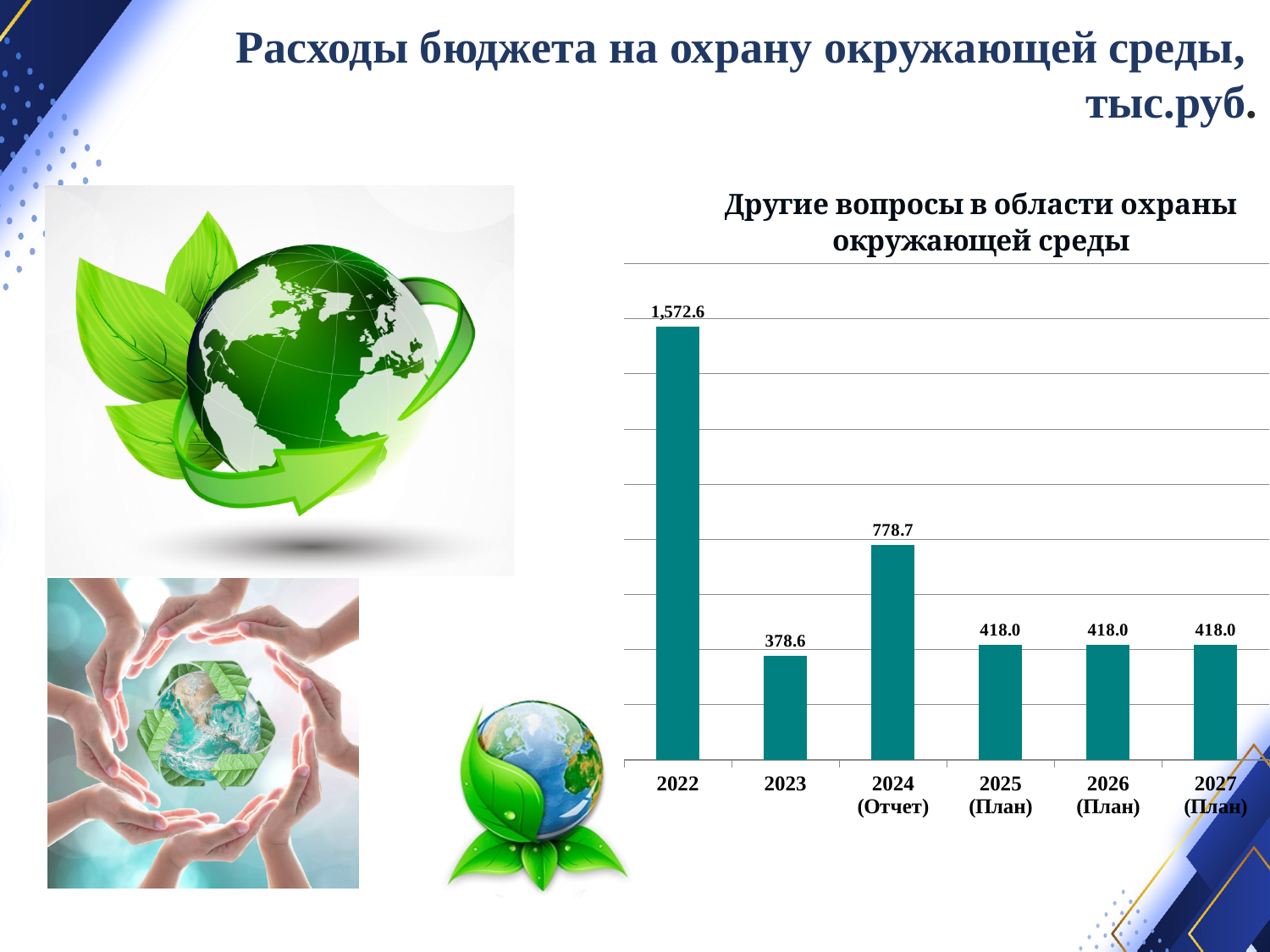
What is the value for 2022? 1,572.6 Which is larger, the value for 2023 or the value for 2025 (План)? 2025 (План) What kind of chart is shown on the slide? bar chart What is the title of the chart? Другие вопросы в области охраны окружающей среды What is the value for 2026 (План)? 418.0 How many years are shown on the x axis? 6 What is the value for 2024 (Отчет)? 778.7 What is the value for 2023? 378.6 Which year has the highest value? 2022 What is the difference between the values for 2022 and 2023? 1,194.0 Which year has the lowest value? 2023 What is the difference between the values for 2024 (Отчет) and 2025 (План)? 360.7